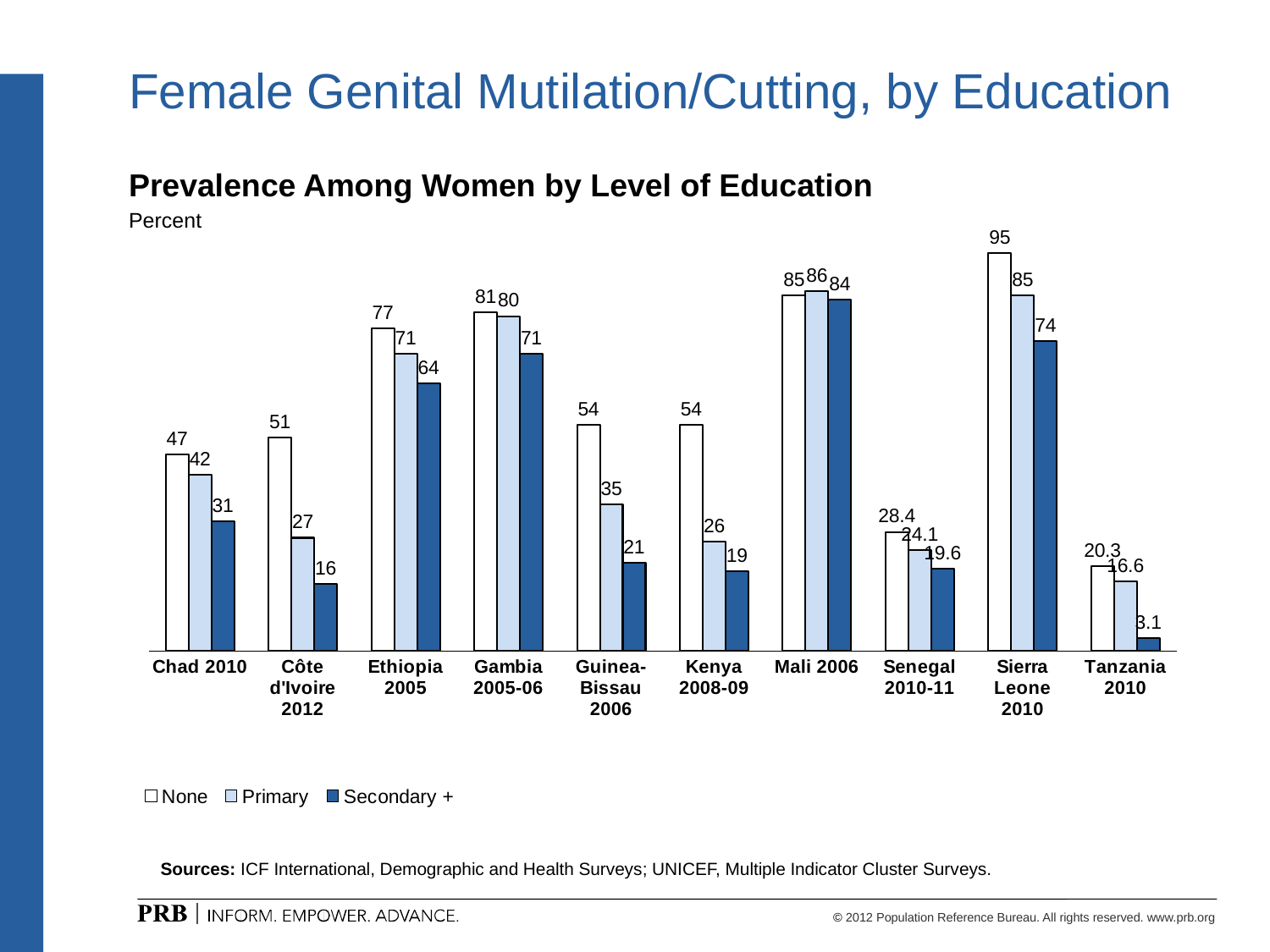
Which is larger: the Primary value for Ethiopia 2005 or the Primary value for Kenya 2008-09? Ethiopia 2005 What kind of chart is shown on the slide? Bar chart What is the value for women with primary education in Guinea-Bissau 2006? 35 Which country has the lowest value for women with secondary or higher education? Tanzania 2010 What is the value for women with no education in Sierra Leone 2010? 95 How many series does the legend list? 3 What is the difference between the None and Secondary + values for Côte d'Ivoire 2012? 35 Which country has the highest value for women with no education? Sierra Leone 2010 What is the value for women with no education in Senegal 2010-11? 28.4 What are the three education levels listed in the legend? None, Primary, Secondary + What is the value for women with secondary or higher education in Tanzania 2010? 3.1 How many countries are shown on the x axis? 10